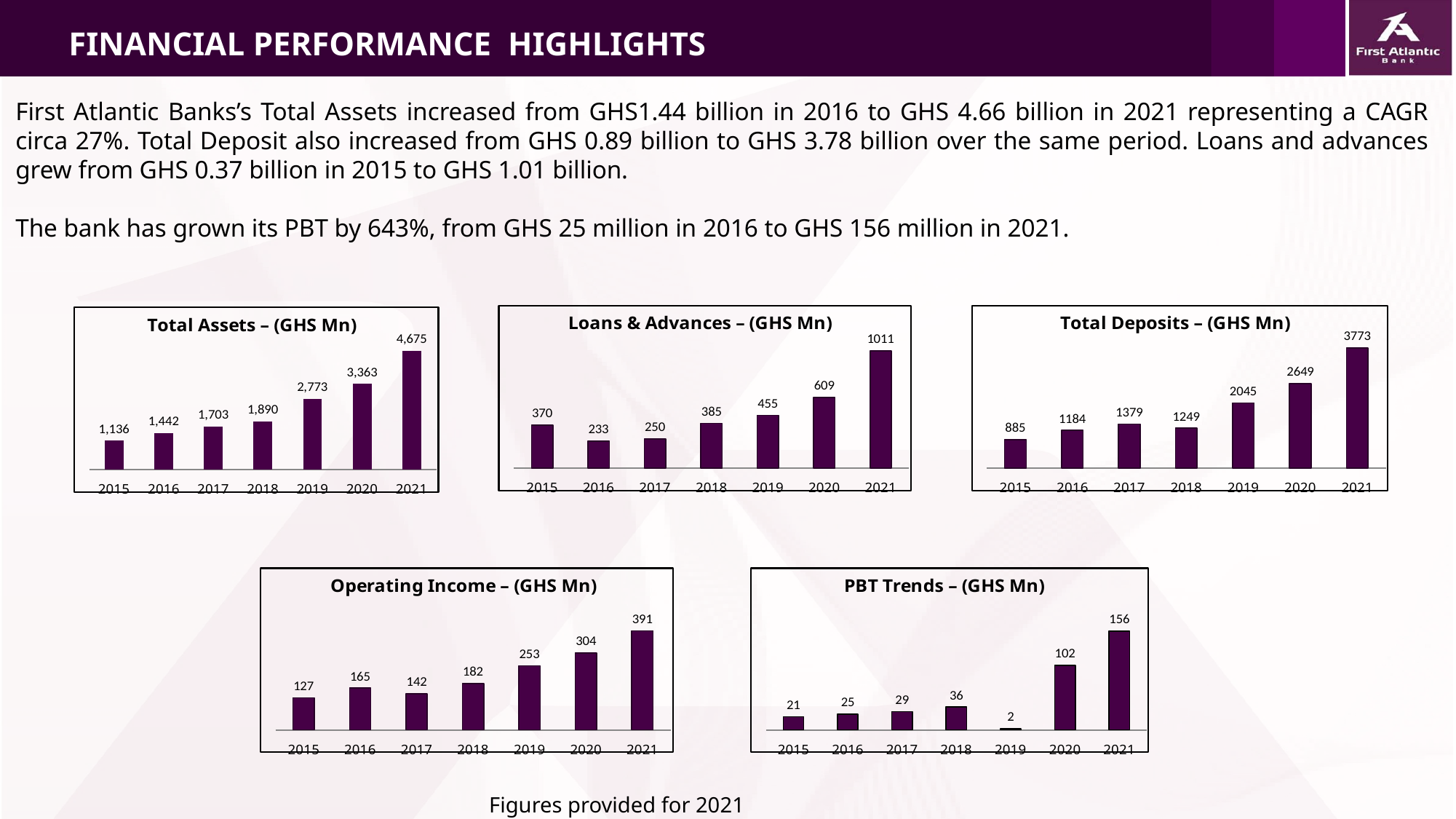
In the PBT Trends – (GHS Mn) chart, which year has the lowest value? 2019 In the Total Assets – (GHS Mn) chart, what is the value for 2019? 2,773 In the Total Deposits – (GHS Mn) chart, what is the value for 2018? 1249 In the Operating Income – (GHS Mn) chart, what is the difference between the 2021 and 2020 values? 87 In the Loans & Advances – (GHS Mn) chart, which year has the lowest value? 2016 What kind of chart is the PBT Trends – (GHS Mn) chart? Bar chart In the Operating Income – (GHS Mn) chart, which year has the highest value? 2021 In the Total Deposits – (GHS Mn) chart, what is the difference between the 2021 and 2015 values? 2888 How many charts are shown on the slide? 5 In the Loans & Advances – (GHS Mn) chart, what is the value for 2020? 609 In the Total Deposits – (GHS Mn) chart, which is larger, the value for 2017 or the value for 2018? 2017 How many years are shown in the Total Assets – (GHS Mn) chart? 7